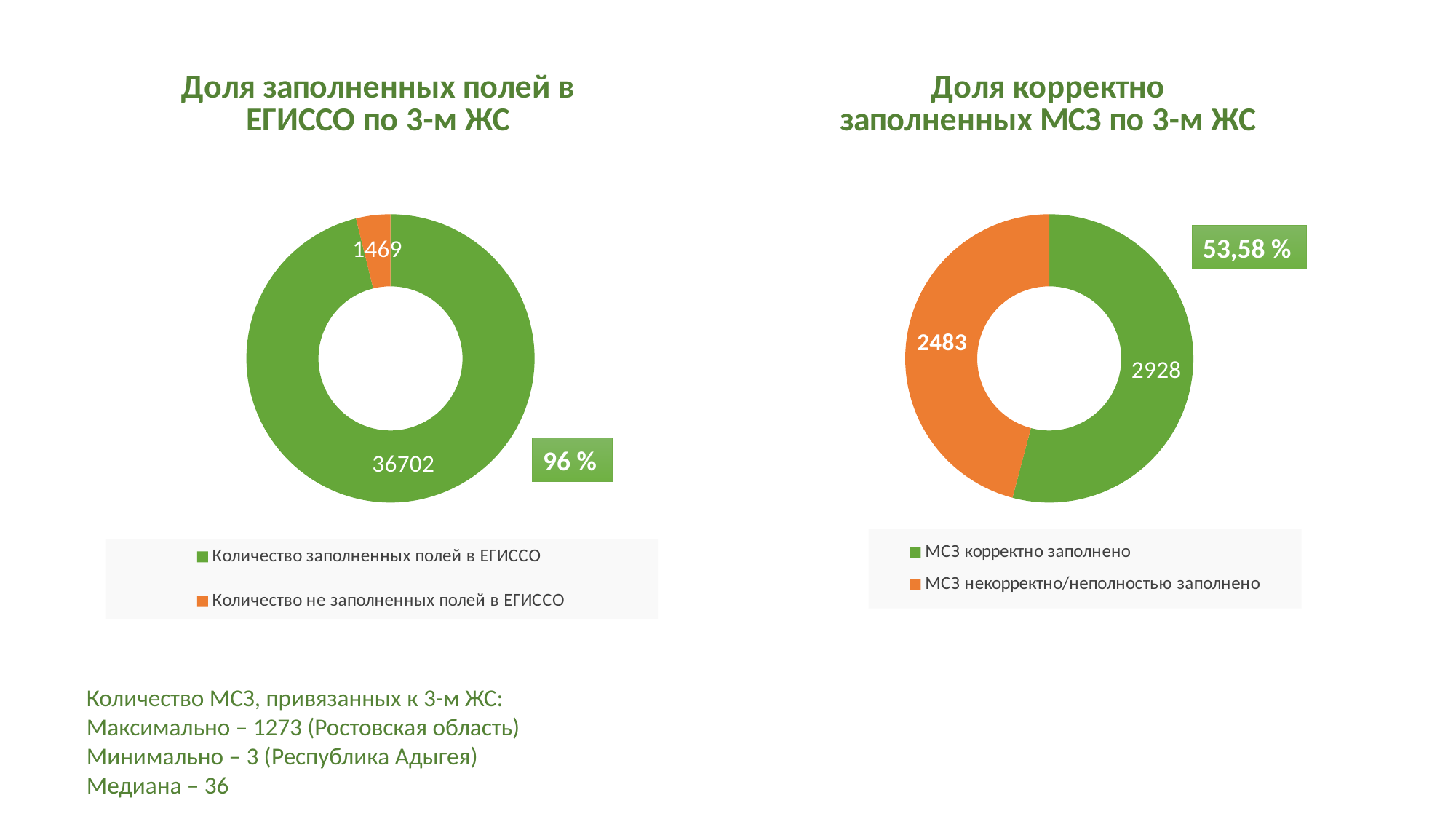
How many entries does the legend of the chart 'Доля заполненных полей в ЕГИССО по 3-м ЖС' list? 2 In the chart 'Доля заполненных полей в ЕГИССО по 3-м ЖС', what is the difference between the filled and unfilled field counts? 35233 In the chart 'Доля заполненных полей в ЕГИССО по 3-м ЖС', what is the value for 'Количество заполненных полей в ЕГИССО'? 36702 In the chart 'Доля заполненных полей в ЕГИССО по 3-м ЖС', what is the value for 'Количество не заполненных полей в ЕГИССО'? 1469 In the chart 'Доля корректно заполненных МСЗ по 3-м ЖС', which category has the smallest value? МСЗ некорректно/неполностью заполнено What type of chart is 'Доля корректно заполненных МСЗ по 3-м ЖС'? Doughnut (pie) chart In the chart 'Доля корректно заполненных МСЗ по 3-м ЖС', what is the total of the two segments? 5411 In the chart 'Доля корректно заполненных МСЗ по 3-м ЖС', what is the value for 'МСЗ некорректно/неполностью заполнено'? 2483 In the chart 'Доля корректно заполненных МСЗ по 3-м ЖС', what is the value for 'МСЗ корректно заполнено'? 2928 In the chart 'Доля заполненных полей в ЕГИССО по 3-м ЖС', what share of the total is shown for the filled fields? 96 % In the chart 'Доля заполненных полей в ЕГИССО по 3-м ЖС', which category has the largest value? Количество заполненных полей в ЕГИССО In the chart 'Доля корректно заполненных МСЗ по 3-м ЖС', what is the difference between correctly filled and incorrectly filled МСЗ? 445